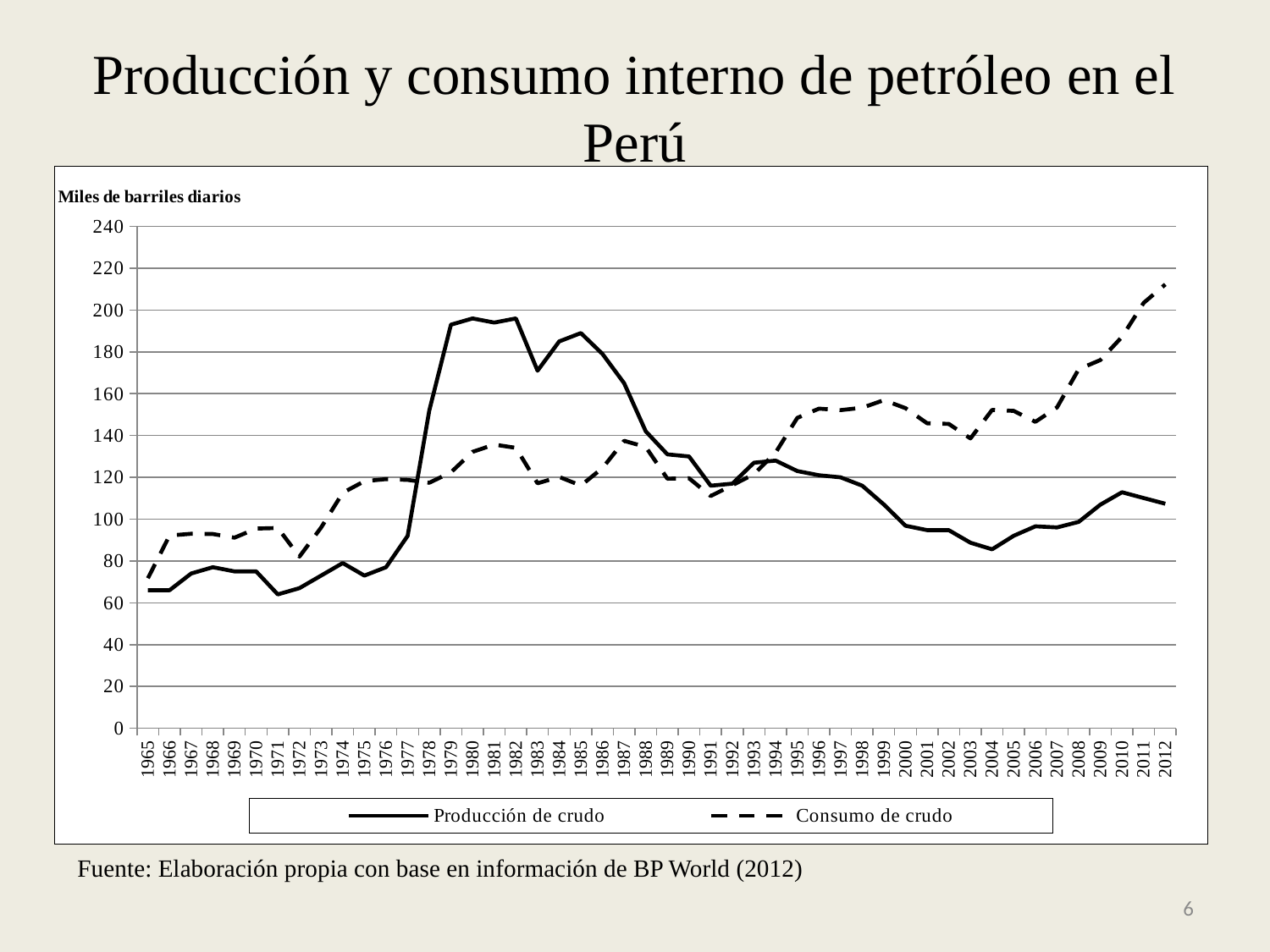
What unit label is shown above the y axis? Miles de barriles diarios What kind of chart is shown on the slide? line chart Is the value for Producción de crudo in 1979 greater or less than 180? greater In 2005, which series has the larger value, Producción de crudo or Consumo de crudo? Consumo de crudo How many years are plotted along the x axis? 48 Is the value for Producción de crudo in 1971 greater or less than 80? less What are the two series named in the legend? Producción de crudo and Consumo de crudo Is the value for Producción de crudo in 2004 greater or less than 100? less How many series does the legend list? 2 In which year does Consumo de crudo reach its highest value? 2012 In 1985, which series has the larger value, Producción de crudo or Consumo de crudo? Producción de crudo